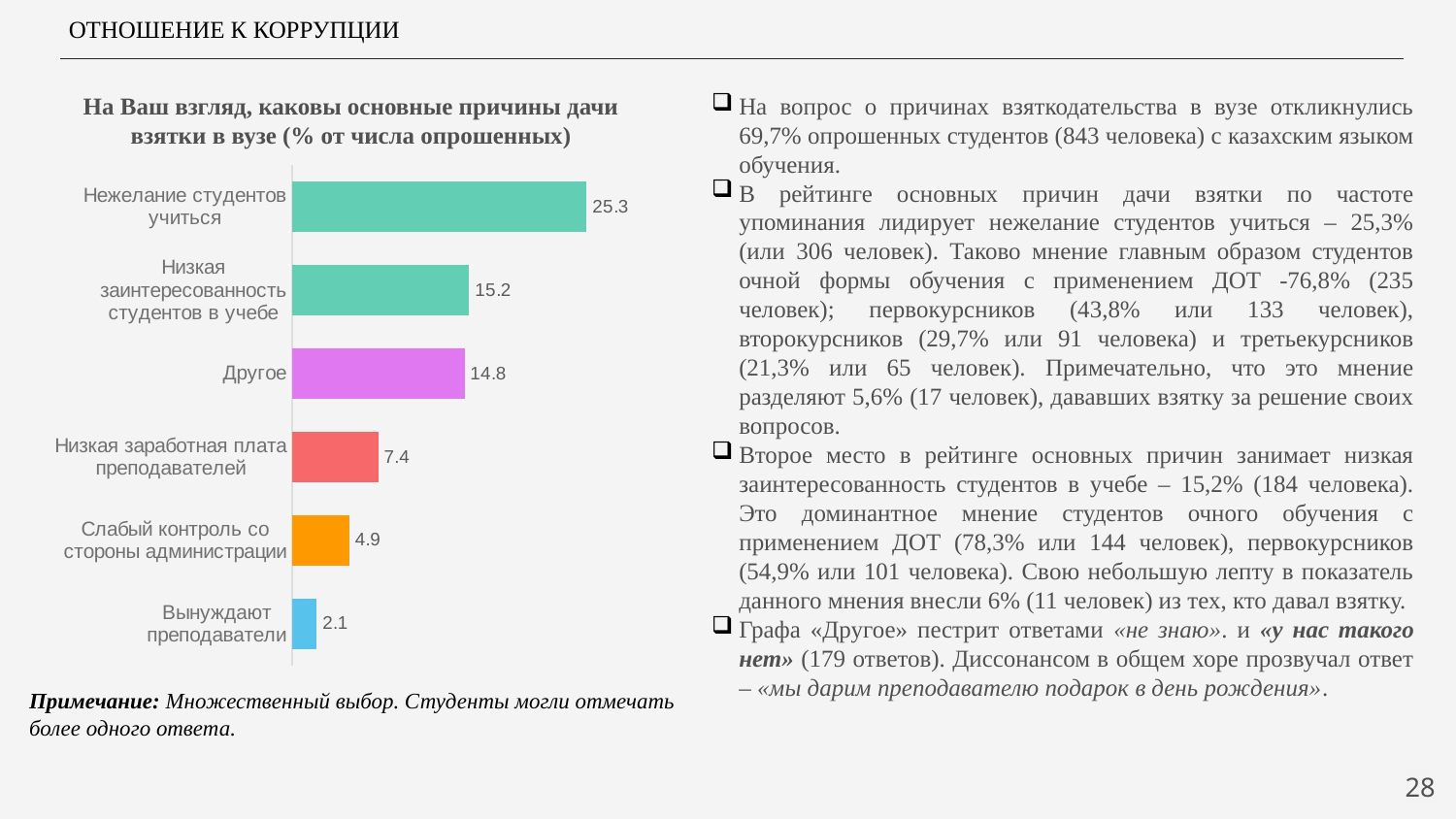
What is the difference between the values for «Нежелание студентов учиться» and «Низкая заинтересованность студентов в учебе»? 10.1 How many categories are shown in the chart? 6 What is the difference between the values for «Другое» and «Вынуждают преподаватели»? 12.7 What value is shown for «Нежелание студентов учиться»? 25.3 Which category has the lowest value? Вынуждают преподаватели What colour is the bar for «Другое»? Purple What is the title of the chart? На Ваш взгляд, каковы основные причины дачи взятки в вузе (% от числа опрошенных) What kind of chart is shown on the slide? Bar chart What value is shown for «Слабый контроль со стороны администрации»? 4.9 Which is larger: the value for «Низкая заинтересованность студентов в учебе» or the value for «Другое»? Низкая заинтересованность студентов в учебе What value is shown for «Низкая заработная плата преподавателей»? 7.4 Which category has the highest value? Нежелание студентов учиться